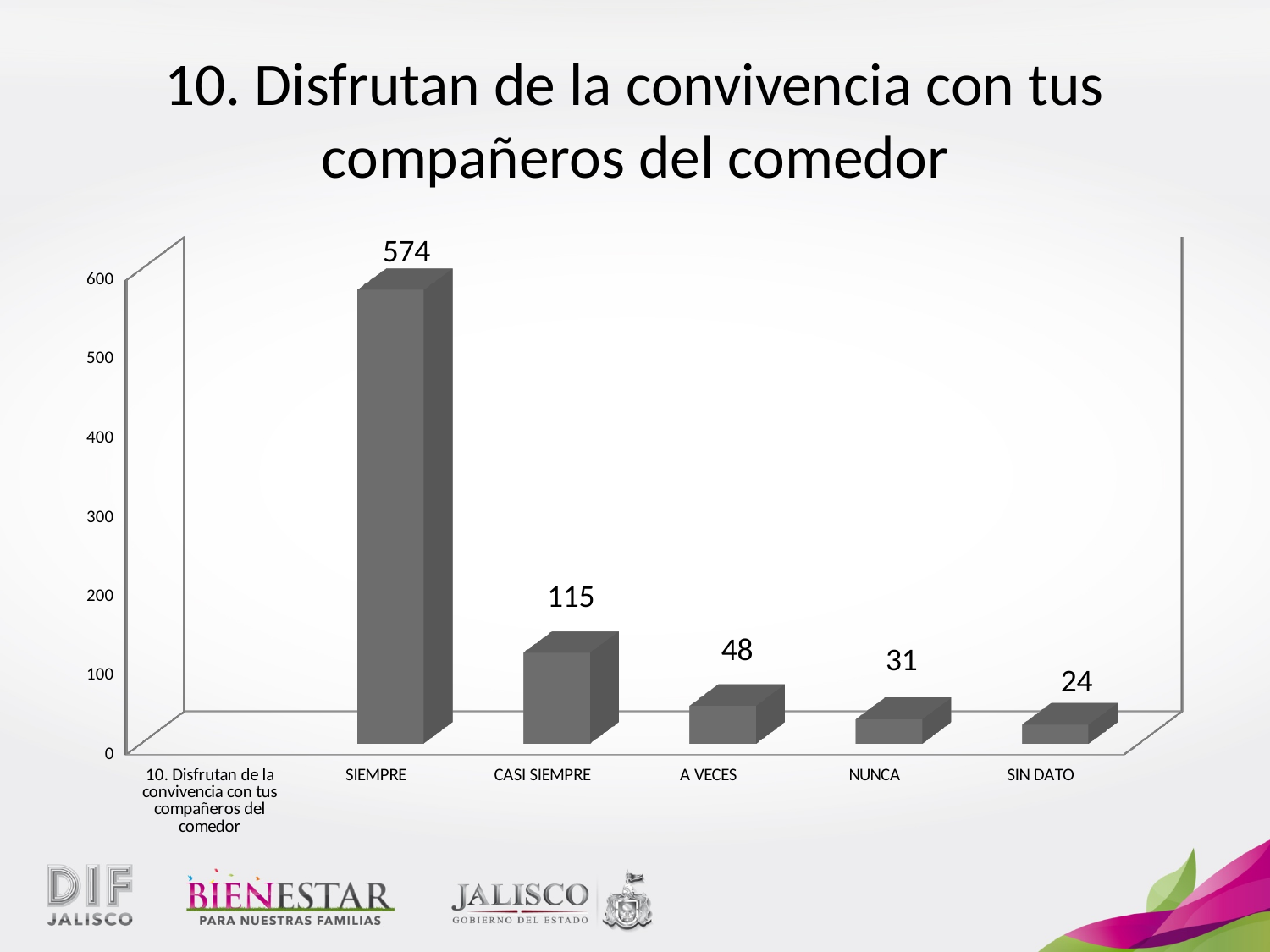
What is the value for CASI SIEMPRE? 115 How many bars are plotted in the chart? 5 What is the value for SIN DATO? 24 What is the value for A VECES? 48 What is the value for NUNCA? 31 Which category has the highest value? SIEMPRE What kind of chart is shown on the slide? bar chart What is the value for SIEMPRE? 574 What is the difference between the values for SIEMPRE and CASI SIEMPRE? 459 Is the value for CASI SIEMPRE greater or less than 200? less Which category has the lowest value? SIN DATO Which is larger, the value for A VECES or the value for NUNCA? A VECES